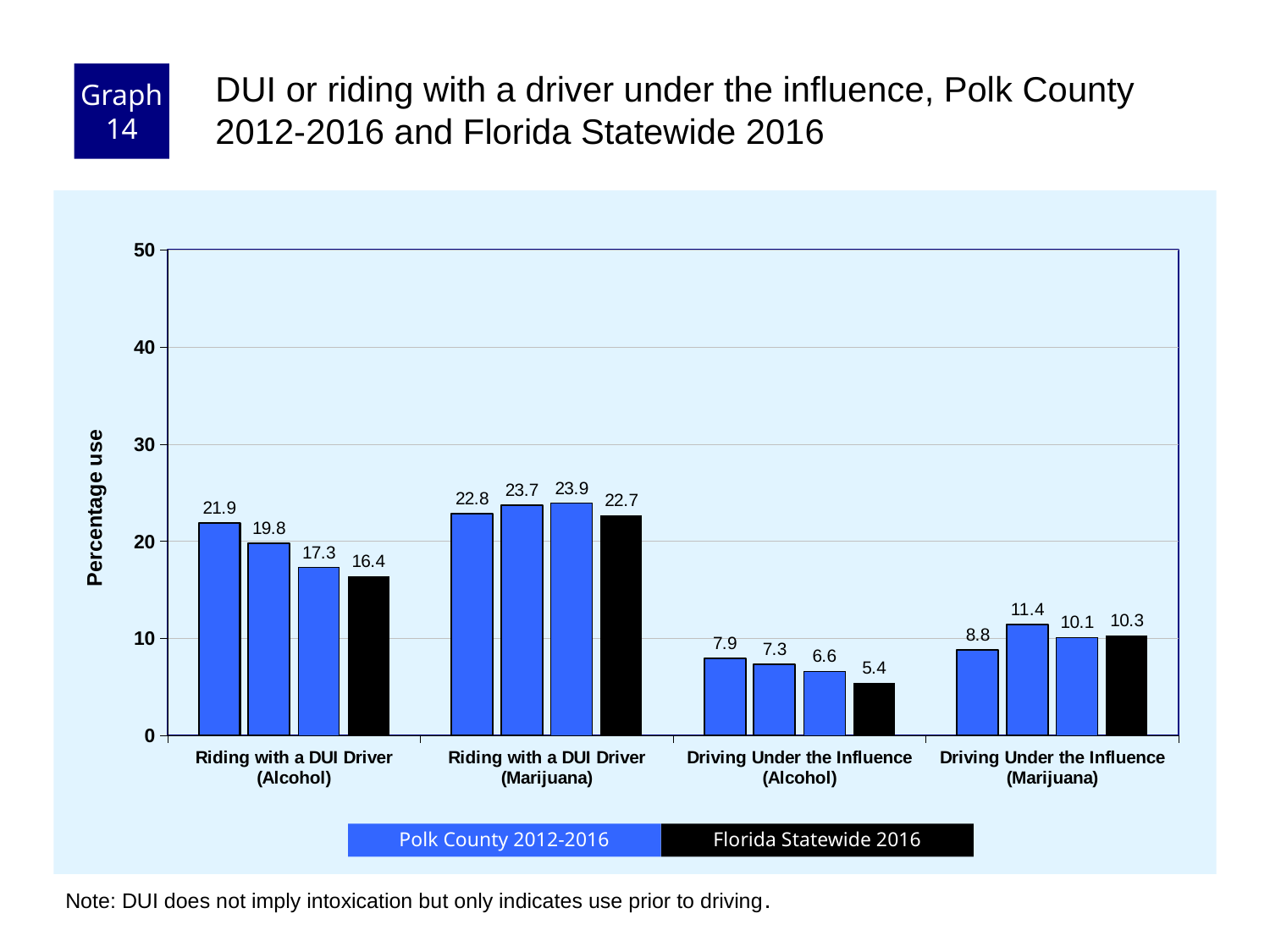
How many categories are shown on the x axis? 4 Is the Florida Statewide 2016 value for Riding with a DUI Driver (Marijuana) greater or less than 20? greater How many series does the legend list? 2 What is the lowest value shown in the chart? 5.4 Do the Polk County 2012-2016 bars for Riding with a DUI Driver (Alcohol) rise or fall from left to right? fall What kind of chart is shown on the slide? bar chart Which category has the tallest bar in the chart? Riding with a DUI Driver (Marijuana) What is the value of the leftmost Polk County 2012-2016 bar for Riding with a DUI Driver (Marijuana)? 22.8 What is the Florida Statewide 2016 value for Riding with a DUI Driver (Alcohol)? 16.4 Is the Florida Statewide 2016 value larger for Riding with a DUI Driver (Marijuana) or for Riding with a DUI Driver (Alcohol)? Riding with a DUI Driver (Marijuana) For Riding with a DUI Driver (Alcohol), what is the difference between the leftmost Polk County 2012-2016 bar and the Florida Statewide 2016 bar? 5.5 What is the Florida Statewide 2016 value for Driving Under the Influence (Alcohol)? 5.4